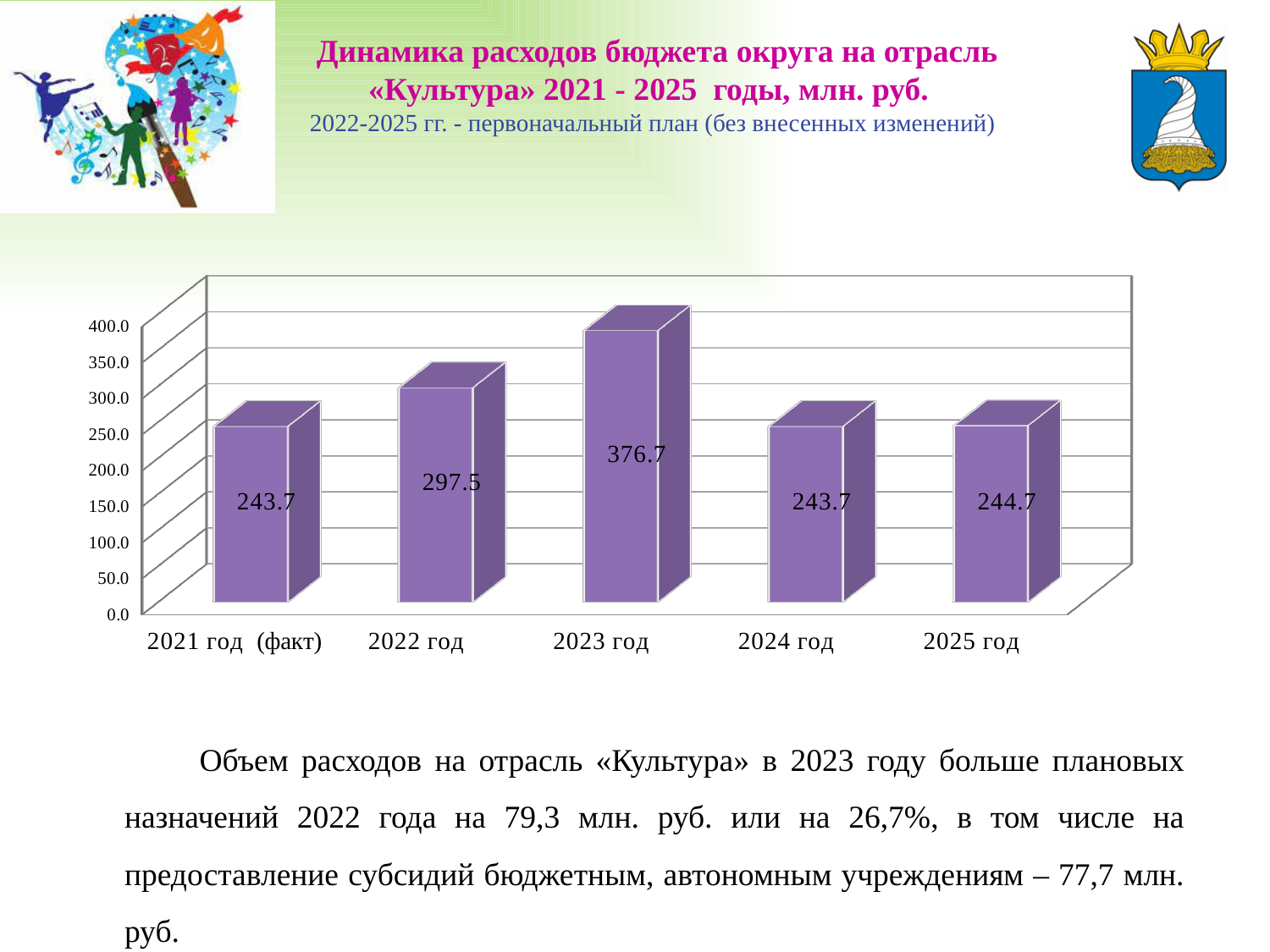
What is the value for 2023 год? 376.7 What is the difference between the values for 2023 год and 2024 год? 133.0 Do the values rise or fall from 2021 год (факт) to 2023 год? rise Which is larger, the value for 2022 год or the value for 2024 год? 2022 год What is the difference between the values for 2022 год and 2021 год (факт)? 53.8 How many years are shown on the x axis? 5 What kind of chart is shown on the slide? bar chart What is the value for 2022 год? 297.5 What is the value for 2021 год (факт)? 243.7 Is the value for 2023 год greater or less than 350.0? greater Which year has the highest value? 2023 год What is the value for 2025 год? 244.7